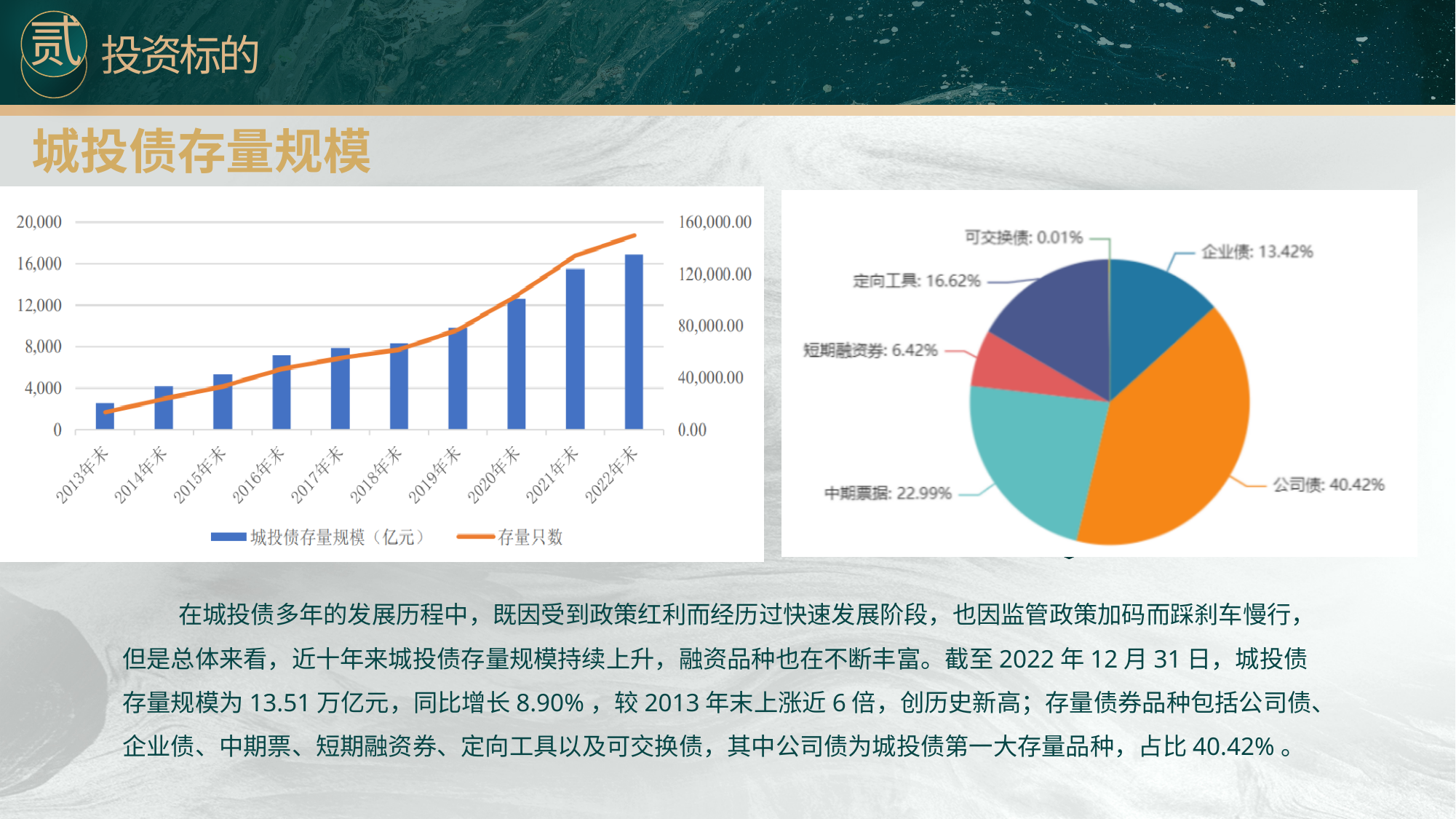
In the right pie chart, what share does 中期票据 have? 22.99% In the left chart, which series is drawn as an orange line? 存量只数 In the left chart, is the 城投债存量规模（亿元） bar for 2016年末 greater or less than 8,000? less In the right pie chart, what is the difference between the shares of 定向工具 and 企业债? 3.20% In the left chart, is the 城投债存量规模（亿元） bar for 2021年末 greater or less than 12,000? greater In the right pie chart, which category has the smallest share? 可交换债 In the left chart, do the 城投债存量规模（亿元） bars rise or fall from 2013年末 to 2022年末? rise In the left chart, how many series does the legend list? 2 In the left chart, which year-end has the lowest bar for 城投债存量规模（亿元）? 2013年末 In the left chart, how many year-end categories are shown on the x axis? 10 In the right pie chart, what share does 公司债 have? 40.42% In the left chart, which year-end has the highest bar for 城投债存量规模（亿元）? 2022年末